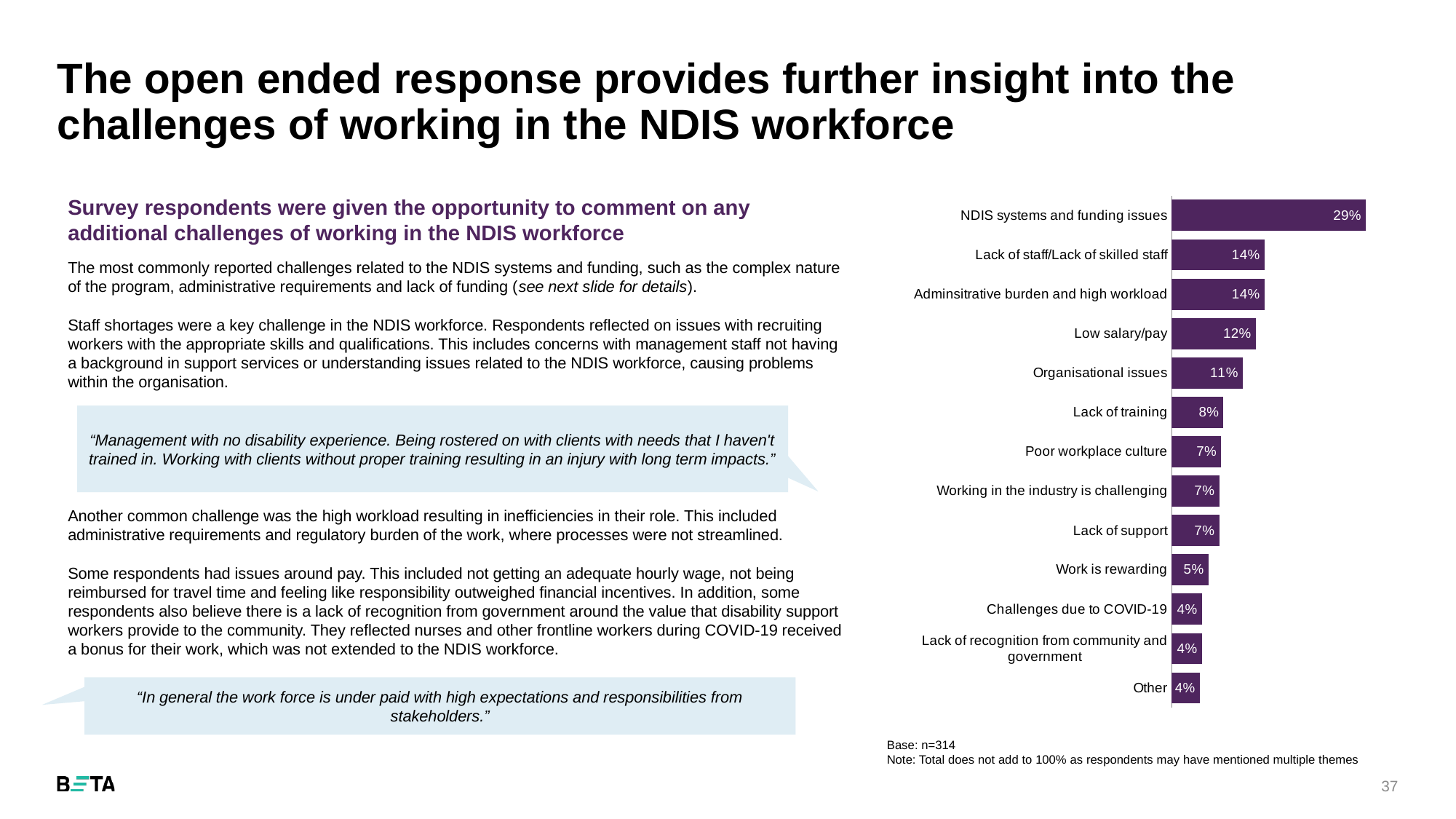
What is the difference between Organisational issues and Lack of training? 3% How many categories are shown in the bar chart? 13 Which category has the highest value in the chart? NDIS systems and funding issues What is the base sample size noted below the chart? n=314 What is the difference between the values for NDIS systems and funding issues and Lack of staff/Lack of skilled staff? 15% What is the value for Work is rewarding? 5% What percentage is shown for Lack of training? 8% What percentage of respondents mentioned NDIS systems and funding issues? 29% What is the value shown for Low salary/pay? 12% What type of chart is shown on the slide? Bar chart Which is larger, the value for Low salary/pay or the value for Poor workplace culture? Low salary/pay What value is shown for Challenges due to COVID-19? 4%